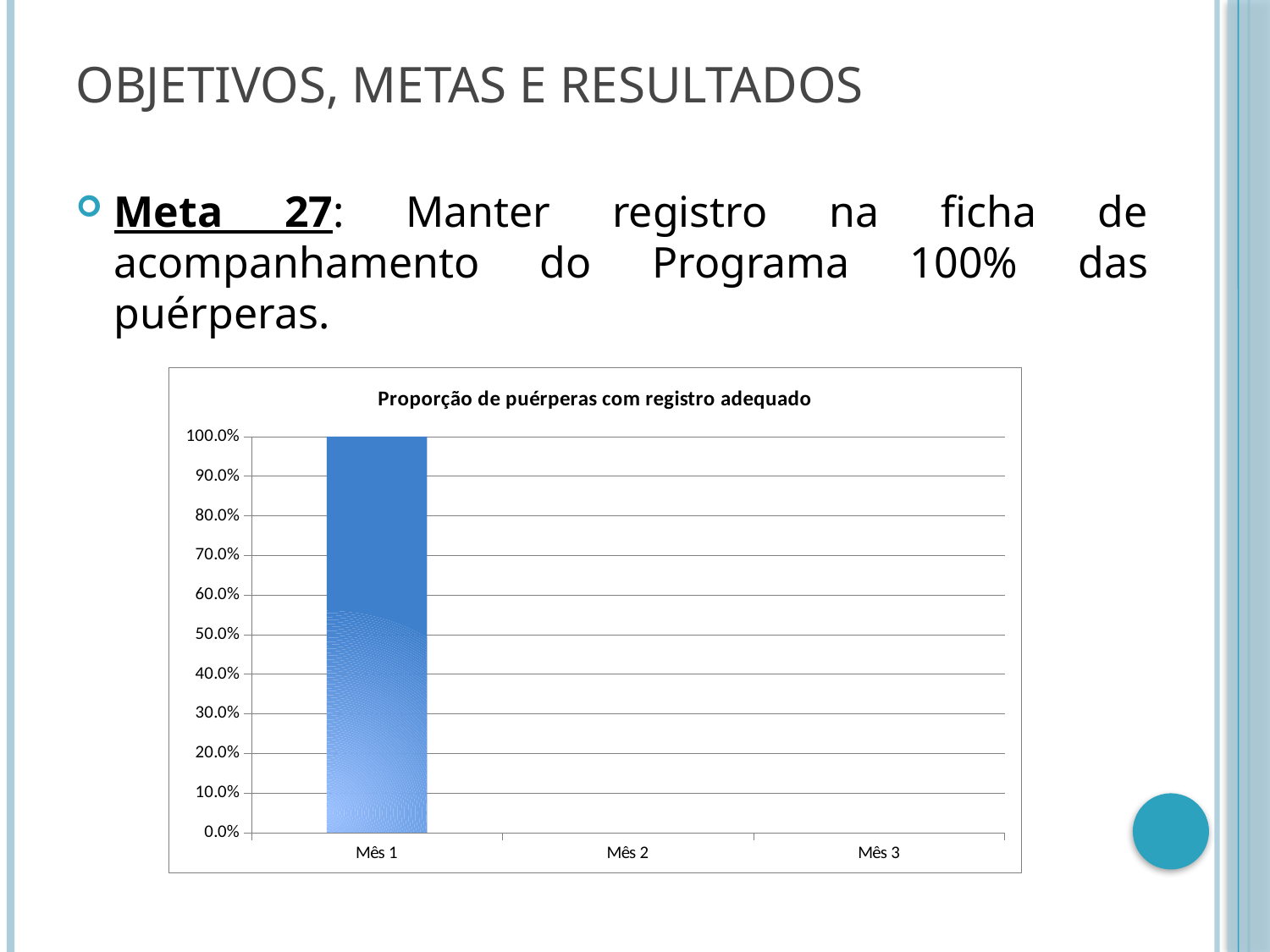
Which is larger, the value for Mês 1 or the value for Mês 2? Mês 1 How many categories are shown on the x axis of the chart? 3 What is the title of the chart? Proporção de puérperas com registro adequado What is the value for Mês 1 in the chart? 100.0% Is the value for Mês 1 greater or less than 90.0%? greater What is the highest value shown on the y axis of the chart? 100.0% How many categories in the chart have a visible bar? 1 What kind of chart is shown on the slide? bar chart Which category has the highest value in the chart? Mês 1